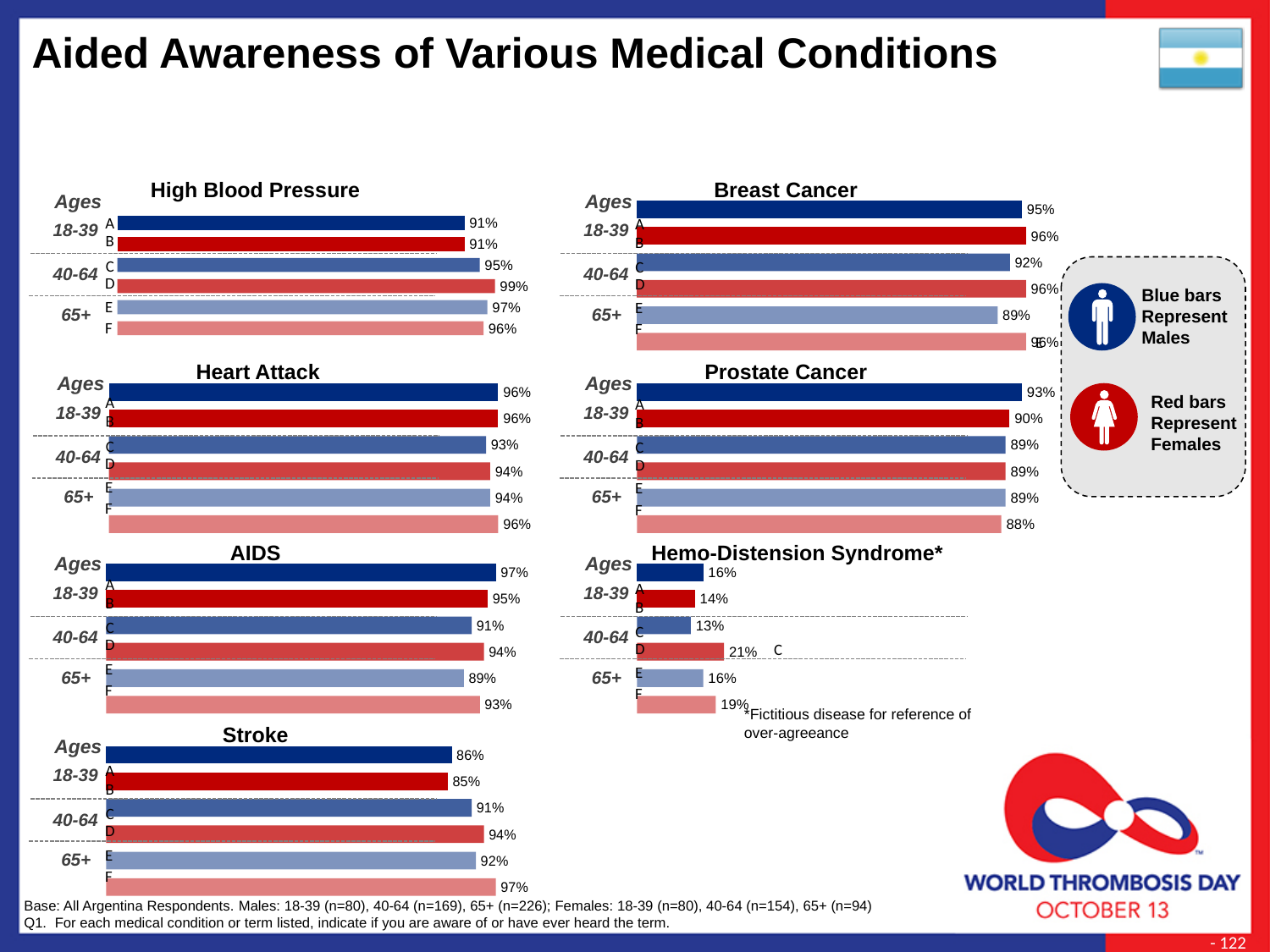
In the AIDS chart, what is the difference between bar A (males 18-39) and bar E (males 65+)? 8 percentage points In the Breast Cancer chart, what is the value for bar E (males 65+)? 89% In the Heart Attack chart, what is the value for bar C (males aged 40-64)? 93% In the Stroke chart, what is the value for bar F (females 65+)? 97% In the Prostate Cancer chart, what is the value for bar A (males aged 18-39)? 93% In the AIDS chart, which bar has the lowest value? E (males 65+) In the Stroke chart, which is larger, bar A (males 18-39) or bar D (females 40-64)? D (females 40-64) In the High Blood Pressure chart, what is the value for bar D (females aged 40-64)? 99% In the High Blood Pressure chart, which bar has the highest value? D (females 40-64) What type of chart is used for each medical condition on this slide? Bar chart In the Hemo-Distension Syndrome chart, what is the value for bar C (males aged 40-64)? 13% In the Hemo-Distension Syndrome chart, which bar has the highest value? D (females 40-64)